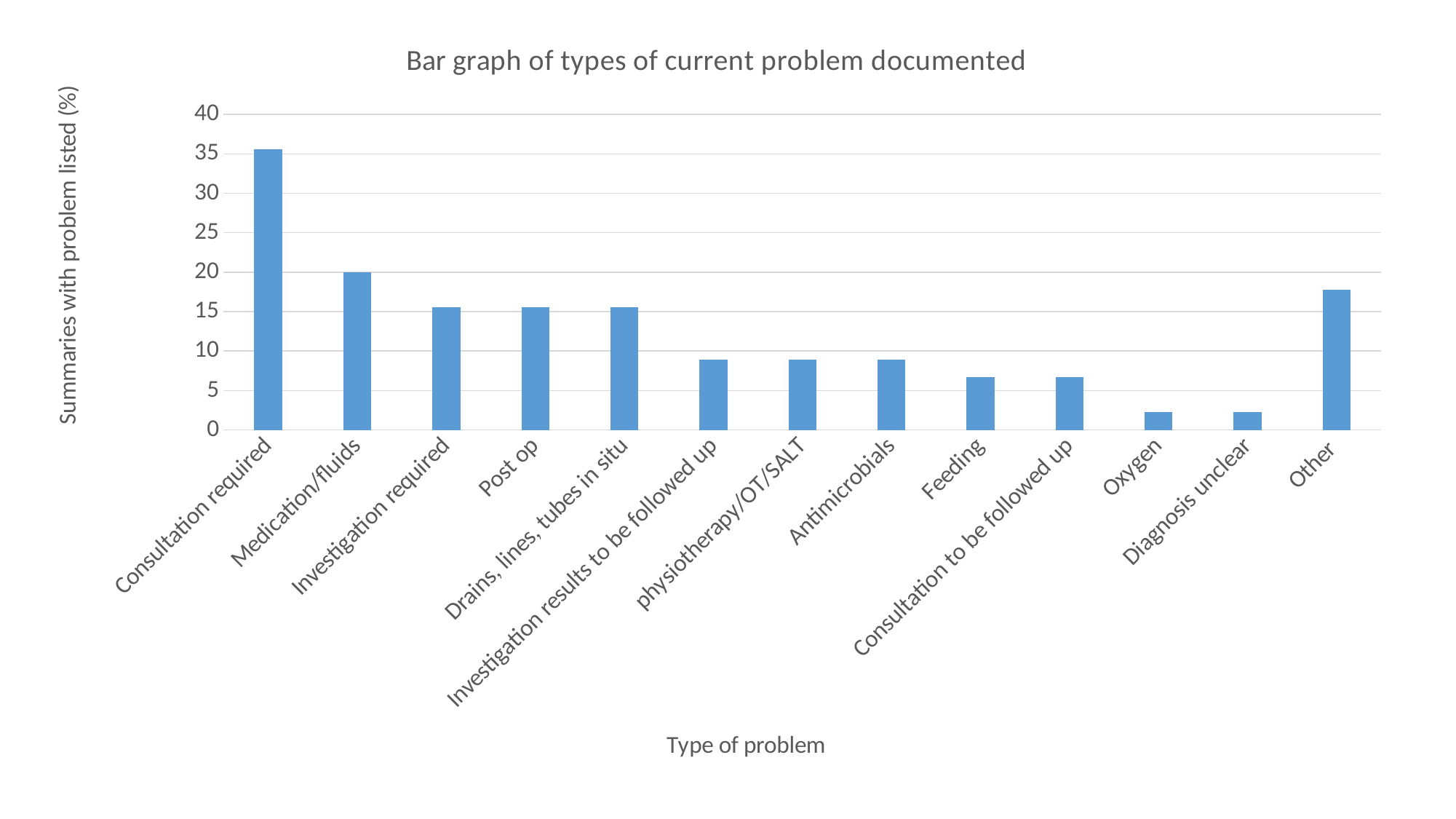
What is the value for Medication/fluids? 20 Is the value for Oxygen greater or less than 5? less Is the value for Antimicrobials greater or less than 5? greater Is the value for Feeding greater or less than 10? less Which is larger, the value for Post op or the value for Feeding? Post op What type of chart is shown on the slide? Bar chart How many types of problem are shown on the x axis? 13 Which type of problem has the highest percentage of summaries? Consultation required Which is larger, the value for Medication/fluids or the value for Other? Medication/fluids What is the title of the chart? Bar graph of types of current problem documented